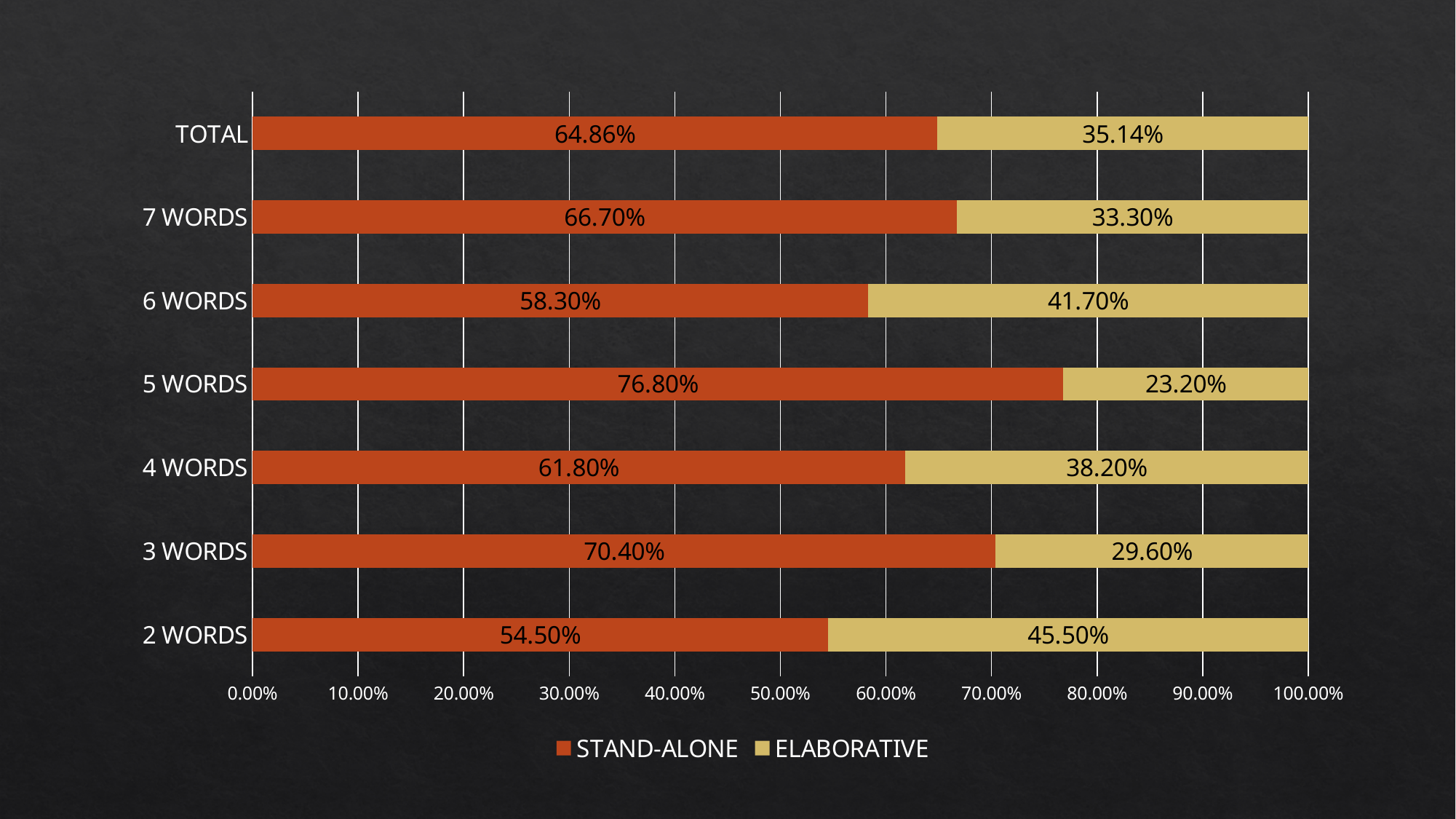
What is the STAND-ALONE value for 5 WORDS? 76.80% How many series does the legend list? 2 What is the difference between the STAND-ALONE values for 3 WORDS and 4 WORDS? 8.60% How many categories are shown on the y axis? 7 Which is larger: the ELABORATIVE value for 7 WORDS or for 4 WORDS? 4 WORDS What is the ELABORATIVE value for 6 WORDS? 41.70% Which category has the highest STAND-ALONE value? 5 WORDS What is the STAND-ALONE value for TOTAL? 64.86% Which category has the lowest STAND-ALONE value? 2 WORDS What is the total of the stacked bar for 6 WORDS? 100.00% What is the ELABORATIVE value for 2 WORDS? 45.50% What kind of chart is shown on the slide? Stacked bar chart